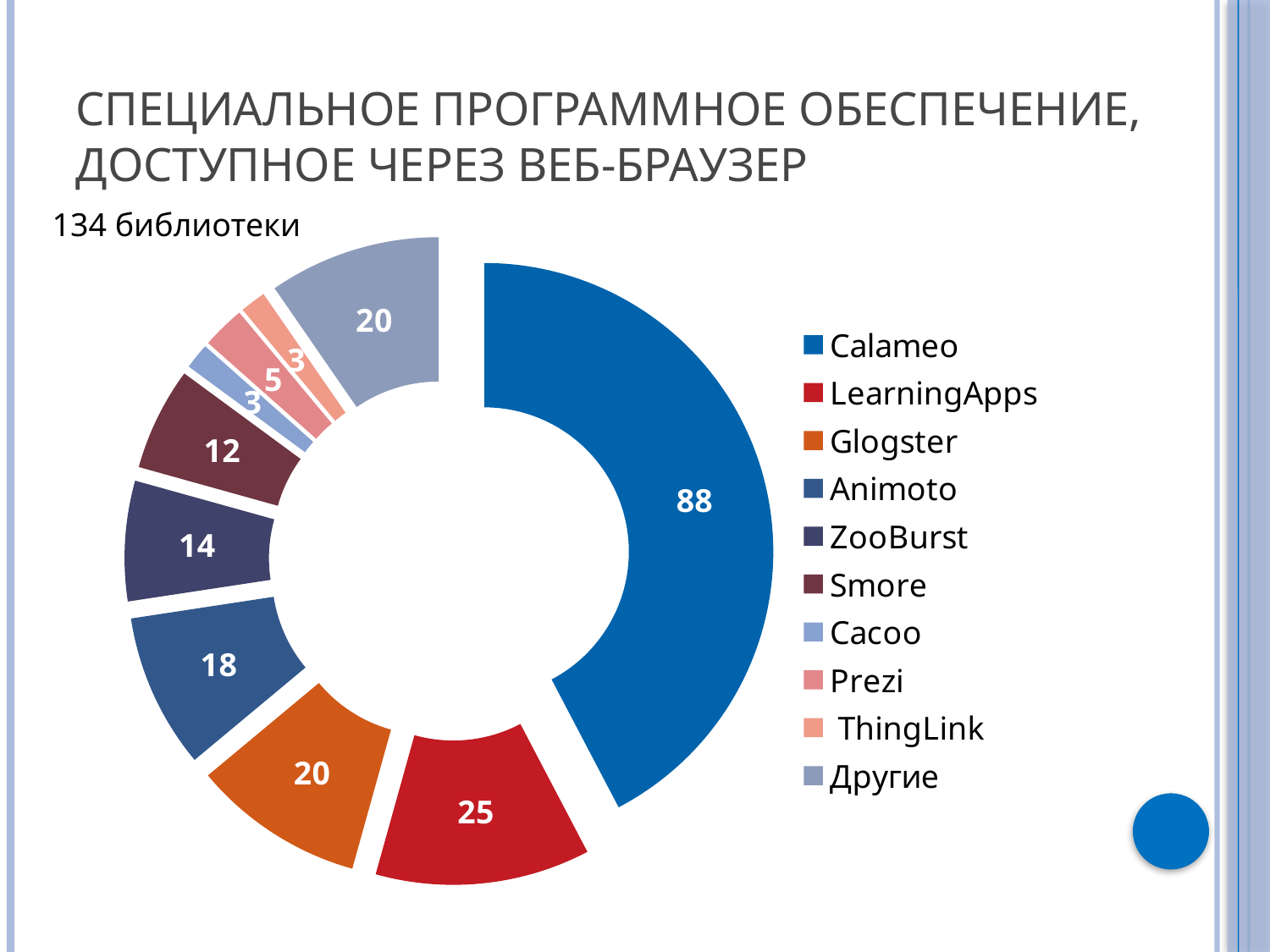
Which is larger, the value for Glogster or the value for Smore? Glogster What is the value for Animoto? 18 What is the value for Calameo? 88 What is the value for Prezi? 5 Which category has the highest value? Calameo What is the value for LearningApps? 25 What is the value for Smore? 12 What kind of chart is shown on the slide? doughnut chart What colour is the Calameo slice? blue What is the difference between the values for Calameo and LearningApps? 63 What is the difference between the values for Animoto and ZooBurst? 4 How many categories does the legend list? 10